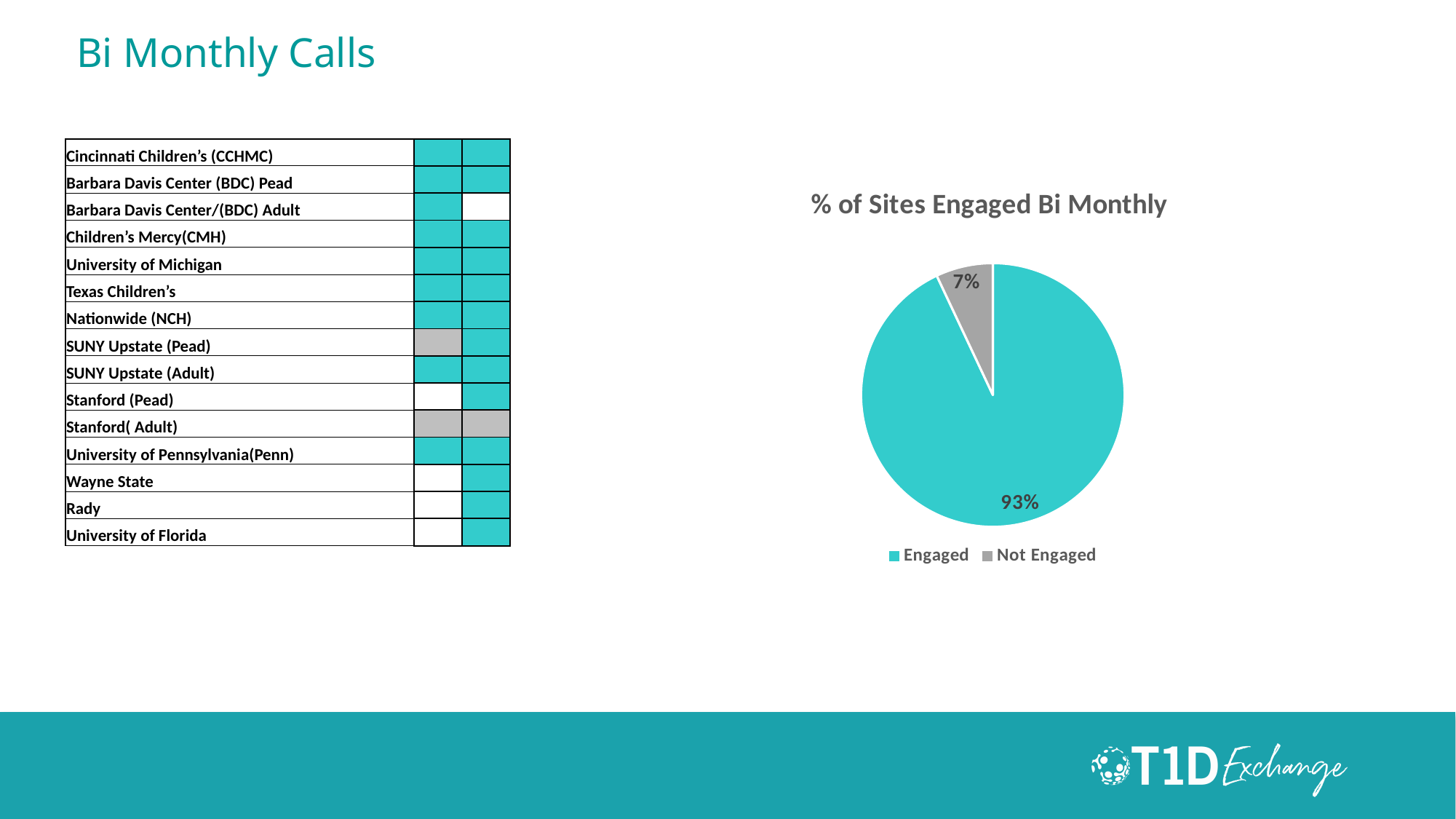
Which slice of the pie chart is the smallest? Not Engaged How many slices does the pie chart have? 2 What is the title of the chart? % of Sites Engaged Bi Monthly What is the difference in percentage points between the Engaged and Not Engaged slices? 86 What percentage of sites are Not Engaged according to the pie chart? 7% What colour represents the Not Engaged slice in the pie chart? grey What type of chart is shown on the slide? pie chart What percentage of sites are Engaged according to the pie chart? 93% Which slice of the pie chart is the largest? Engaged How many entries does the legend of the pie chart list? 2 Is the Engaged share of the pie chart greater or less than 50%? greater Which is larger in the pie chart, Engaged or Not Engaged? Engaged